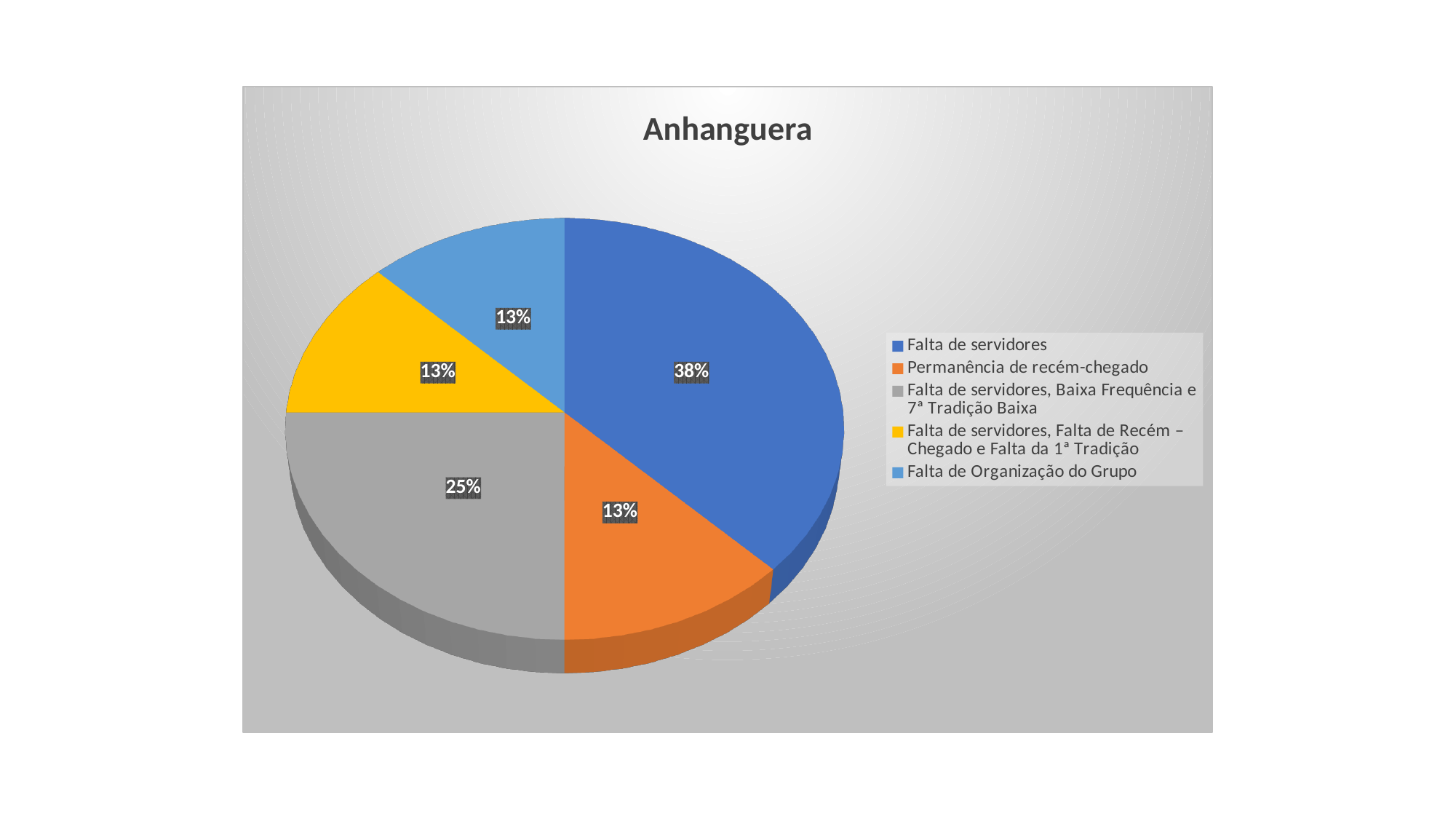
What kind of chart is shown on the slide? pie chart What share of the pie does "Permanência de recém-chegado" have? 13% What share of the pie does "Falta de Organização do Grupo" have? 13% Which is larger, the share of "Falta de servidores, Baixa Frequência e 7ª Tradição Baixa" or the share of "Permanência de recém-chegado"? Falta de servidores, Baixa Frequência e 7ª Tradição Baixa What is the title of the chart? Anhanguera What colour is the slice for "Falta de servidores, Falta de Recém – Chegado e Falta da 1ª Tradição"? yellow What share of the pie does "Falta de servidores, Baixa Frequência e 7ª Tradição Baixa" have? 25% How many entries does the legend list? 5 How many slices does the pie chart have? 5 Which category has the largest slice of the pie? Falta de servidores What is the difference between the shares of "Falta de servidores" and "Falta de servidores, Baixa Frequência e 7ª Tradição Baixa"? 13%